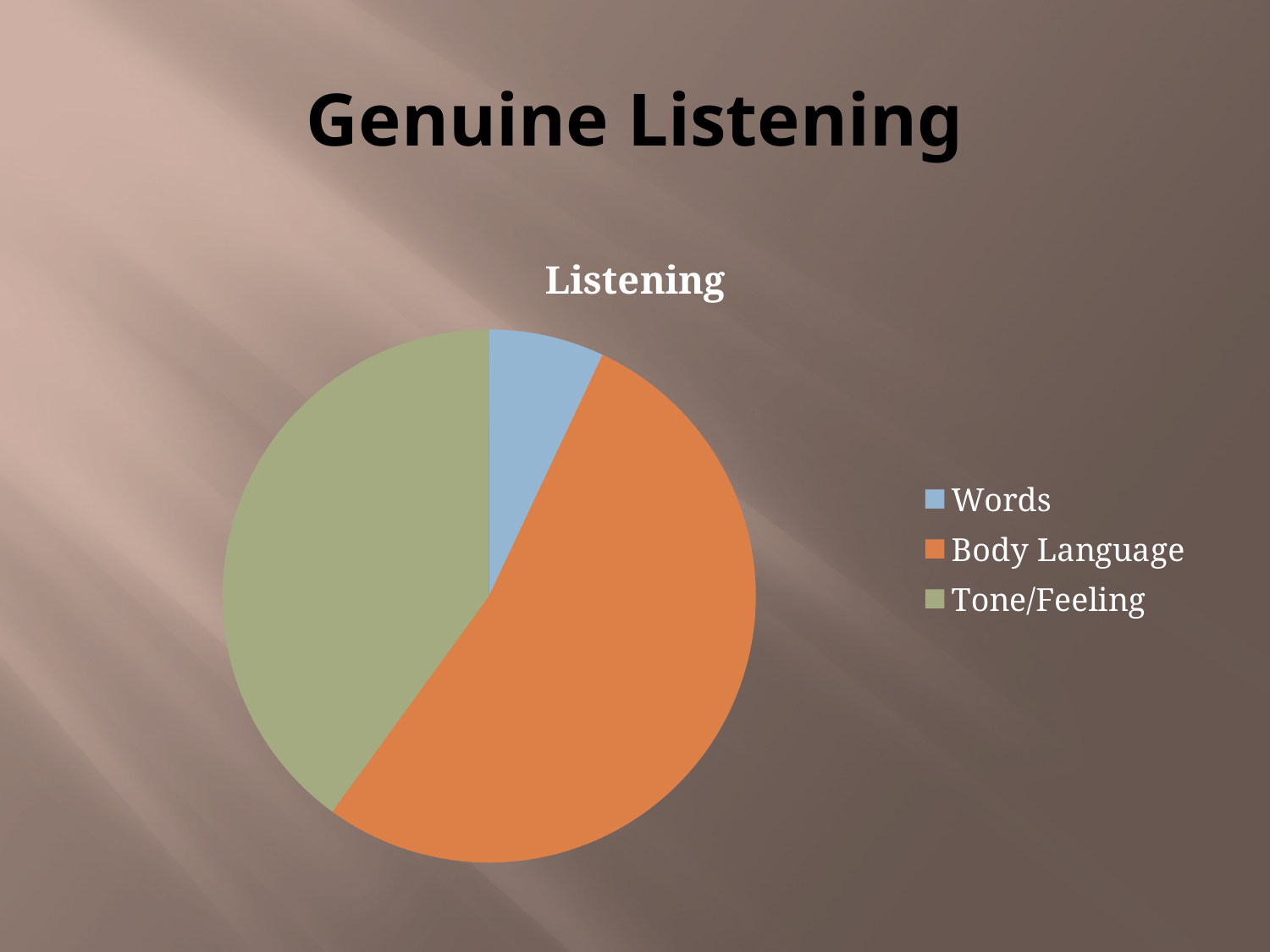
Which category has the largest slice of the pie? Body Language Which category is shown in orange? Body Language What is the title of the chart? Listening How many slices does the pie chart have? 3 Which slice is larger, Words or Body Language? Body Language Which slice is larger, Words or Tone/Feeling? Tone/Feeling What kind of chart is shown on the slide? Pie chart What are the three categories listed in the legend? Words, Body Language, Tone/Feeling Which category has the smallest slice of the pie? Words How many entries does the legend list? 3